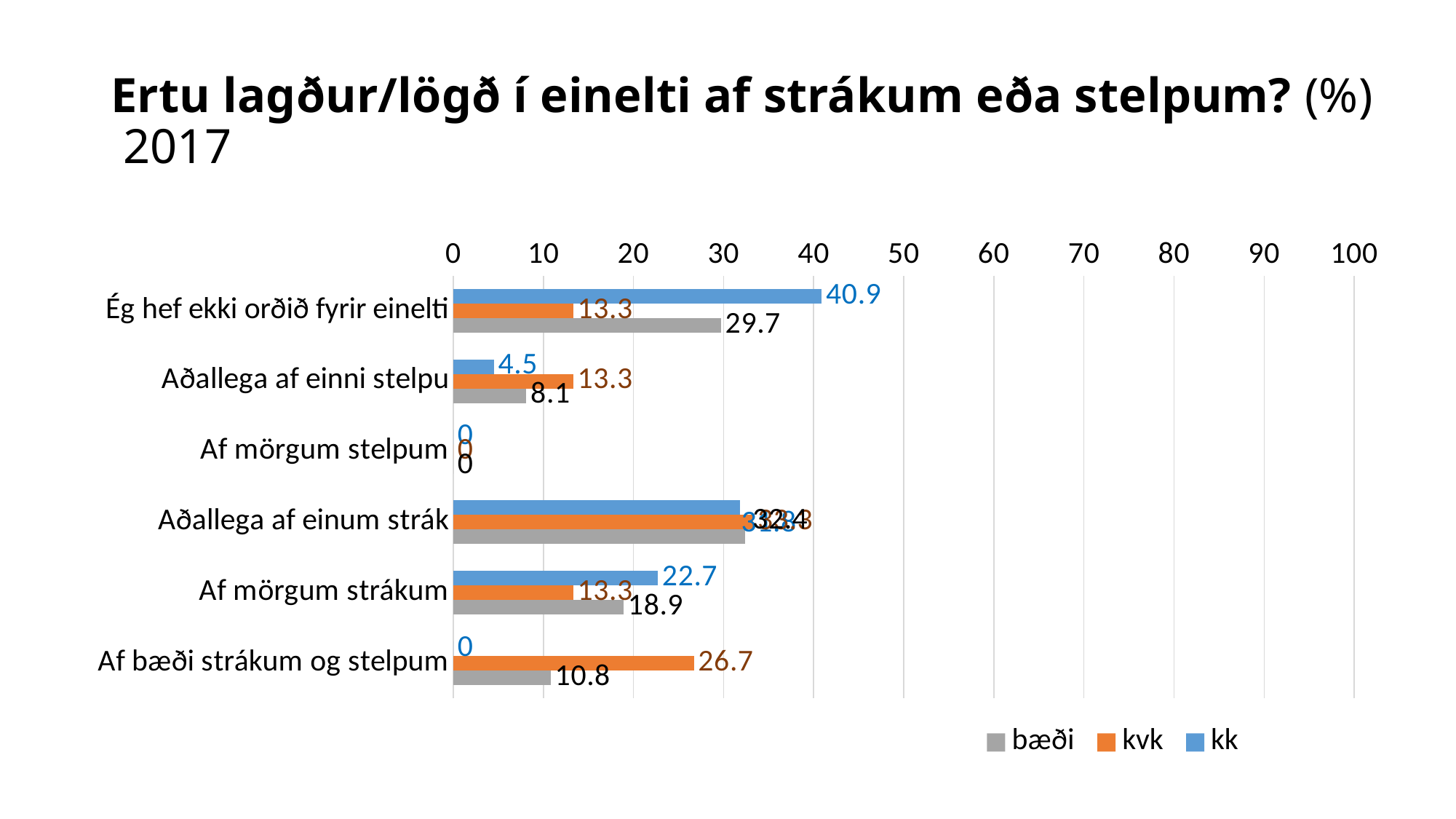
What is the bæði value for "Af mörgum strákum"? 18.9 What is the difference between the kk and kvk values for "Af mörgum strákum"? 9.4 Is the bæði value for "Ég hef ekki orðið fyrir einelti" greater or less than 20? greater What is the kk value for "Ég hef ekki orðið fyrir einelti"? 40.9 What is the kk value for "Aðallega af einni stelpu"? 4.5 How many categories are shown on the y axis of the chart? 6 What is the kvk value for "Af bæði strákum og stelpum"? 26.7 How many series does the legend list? 3 Which series has the highest value for "Ég hef ekki orðið fyrir einelti"? kk Which series has the lowest value for "Af bæði strákum og stelpum"? kk What kind of chart is shown on the slide? bar chart Which is larger for "Aðallega af einni stelpu": the kvk value or the bæði value? kvk